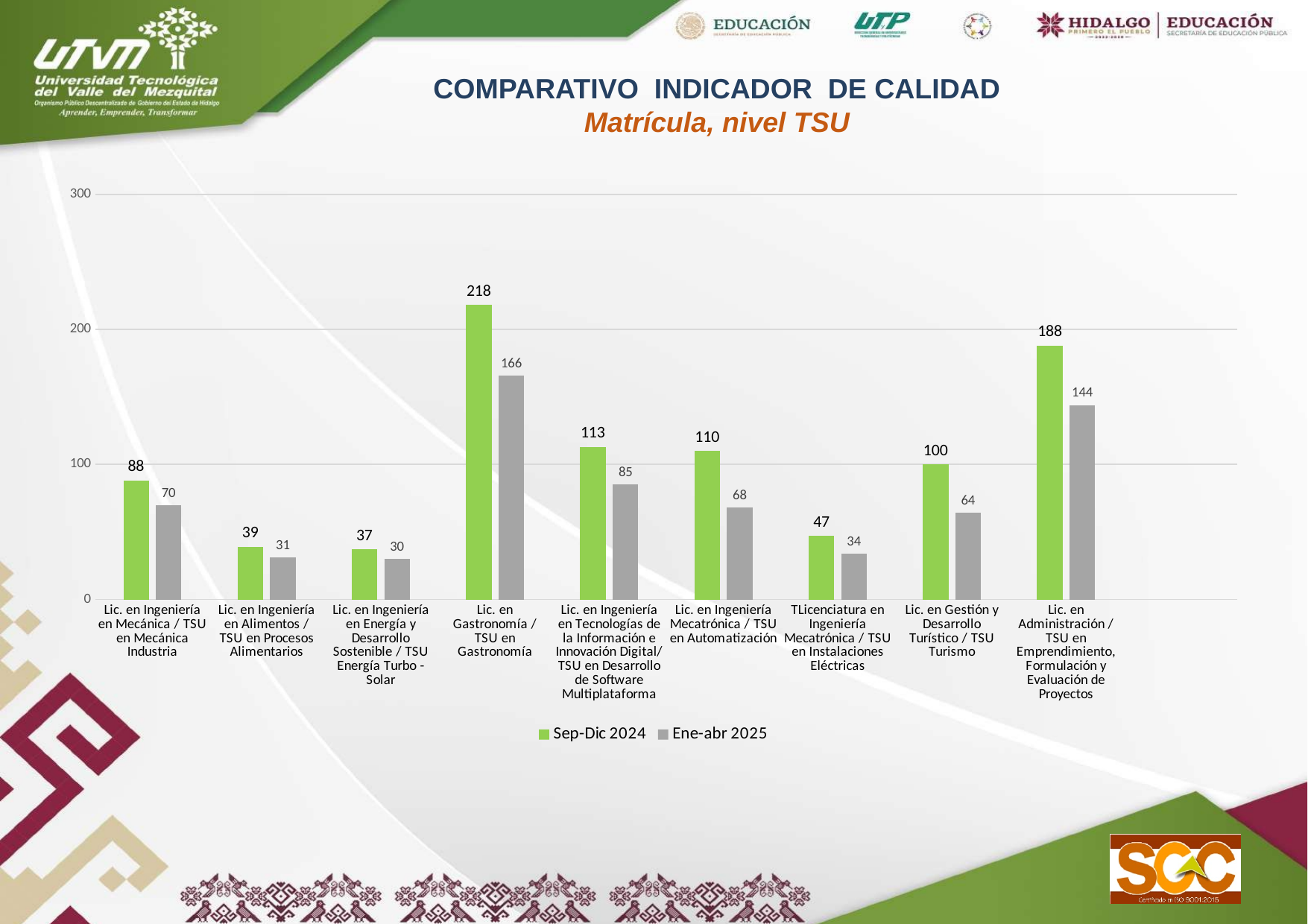
What is the Sep-Dic 2024 value for TLicenciatura en Ingeniería Mecatrónica / TSU en Instalaciones Eléctricas? 47 What is the Ene-abr 2025 value for Lic. en Administración / TSU en Emprendimiento, Formulación y Evaluación de Proyectos? 144 Which category has the lowest Ene-abr 2025 value? Lic. en Ingeniería en Energía y Desarrollo Sostenible / TSU Energía Turbo - Solar What is the difference between the Sep-Dic 2024 and Ene-abr 2025 values for Lic. en Gastronomía / TSU en Gastronomía? 52 How many categories are shown on the x axis? 9 What is the Sep-Dic 2024 value for Lic. en Gastronomía / TSU en Gastronomía? 218 What is the Ene-abr 2025 value for Lic. en Ingeniería Mecatrónica / TSU en Automatización? 68 Which category has the highest Sep-Dic 2024 value? Lic. en Gastronomía / TSU en Gastronomía Which is larger: the Sep-Dic 2024 value for Lic. en Gestión y Desarrollo Turístico / TSU Turismo or the Ene-abr 2025 value for Lic. en Ingeniería en Tecnologías de la Información e Innovación Digital / TSU en Desarrollo de Software Multiplataforma? Sep-Dic 2024 value for Lic. en Gestión y Desarrollo Turístico / TSU Turismo What are the two series listed in the legend? Sep-Dic 2024 and Ene-abr 2025 What kind of chart is shown on the slide? Bar chart How many series does the legend list? 2